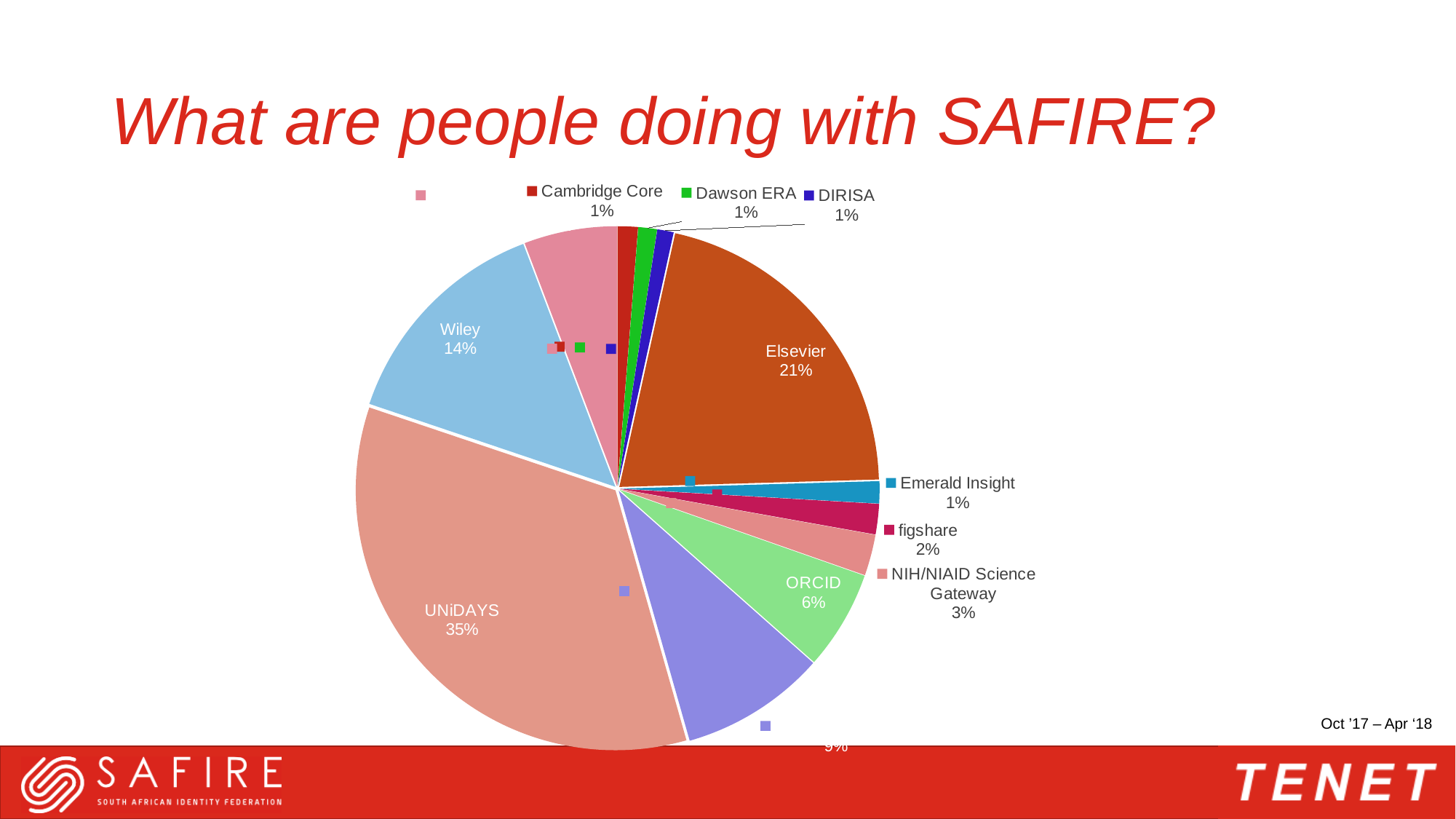
Which is larger, the share for Elsevier or the share for Wiley? Elsevier What percentage is shown for NIH/NIAID Science Gateway? 3% What percentage is shown for Wiley? 14% What kind of chart is shown on the slide? pie chart What percentage is shown for ORCID? 6% What share of the pie does UNiDAYS account for? 35% What percentage is shown for Elsevier? 21% What time period does the chart cover, according to the note on the slide? Oct '17 – Apr '18 What is the difference in percentage points between UNiDAYS and Elsevier? 14 What is the difference in percentage points between Wiley and ORCID? 8 What percentage is shown for figshare? 2% Which service has the largest slice of the pie? UNiDAYS